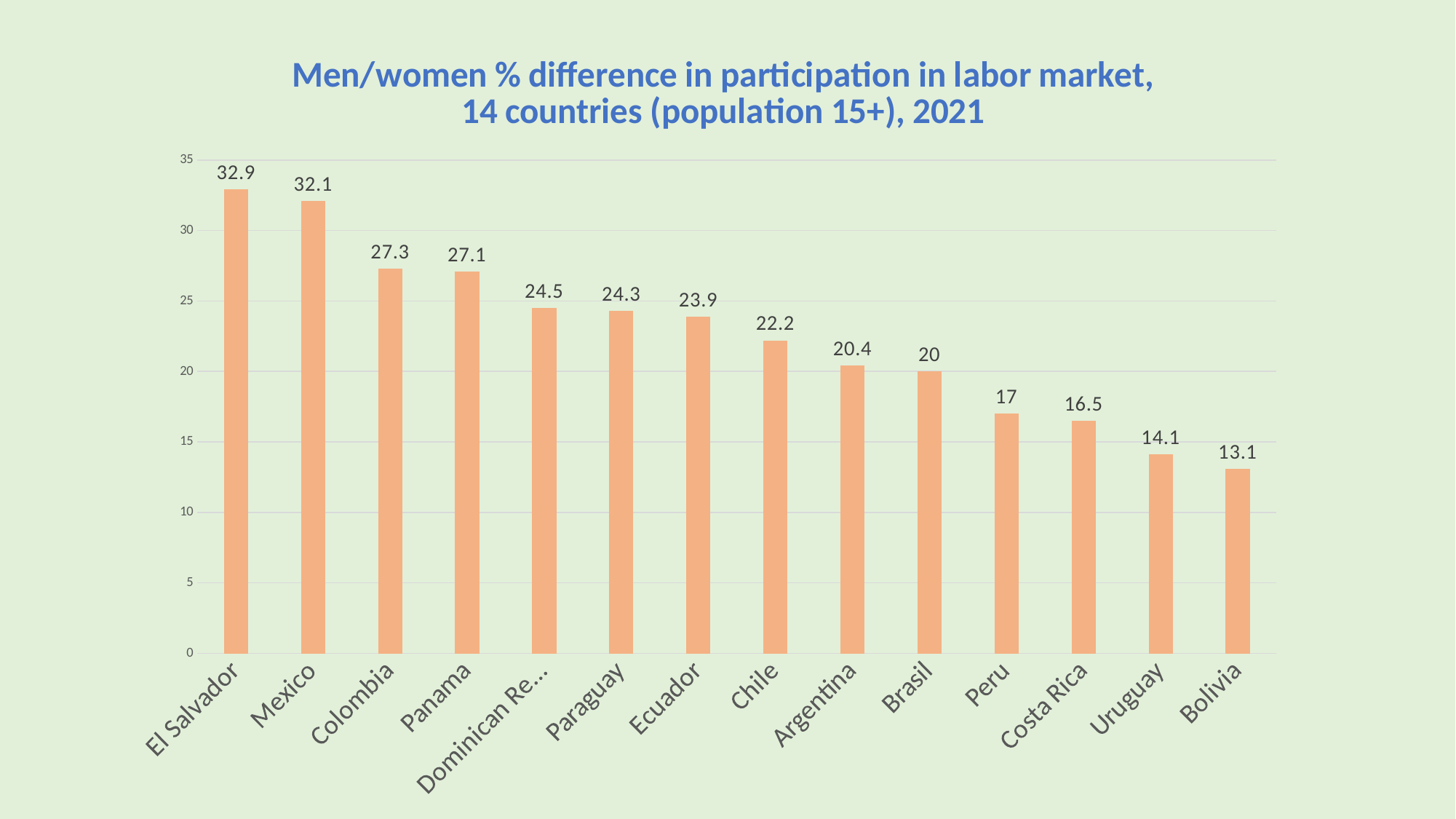
Which country has the highest value? El Salvador How many countries are shown in the chart? 14 What is the value for El Salvador? 32.9 What is the difference between the values for Mexico and Peru? 15.1 What is the difference between the values for Colombia and Bolivia? 14.2 Do the values rise or fall from left to right along the x axis? Fall Is the value for Uruguay greater or less than 15? less Which is larger, the value for Ecuador or the value for Argentina? Ecuador What is the value for Chile? 22.2 Which country has the lowest value? Bolivia What kind of chart is shown on the slide? Bar chart What is the value for Costa Rica? 16.5